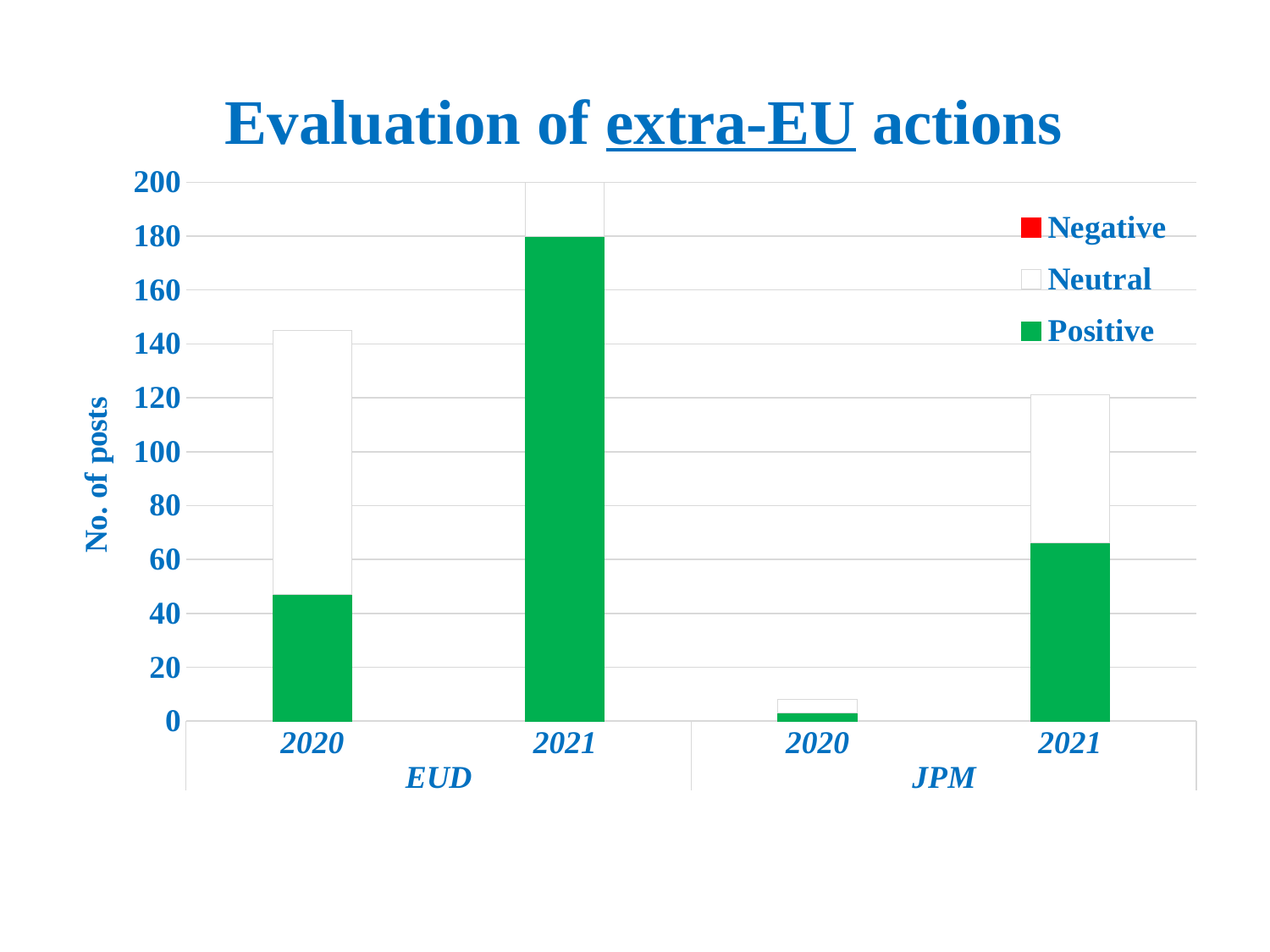
Which bar has the highest total number of posts? EUD 2021 How many bars are plotted in the chart? 4 Is the Positive value for JPM in 2021 greater or less than 60? greater Is the total number of posts for JPM in 2020 greater or less than 20? less What is the Positive value for EUD in 2021? 180 Is the Positive value for EUD in 2020 greater or less than 40? greater What kind of chart is shown on the slide? bar chart Which has a larger total number of posts, EUD 2020 or JPM 2021? EUD 2020 What is the label on the vertical axis of the chart? No. of posts Which bar has the lowest total number of posts? JPM 2020 How many series does the legend list? 3 What is the title of the chart? Evaluation of extra-EU actions